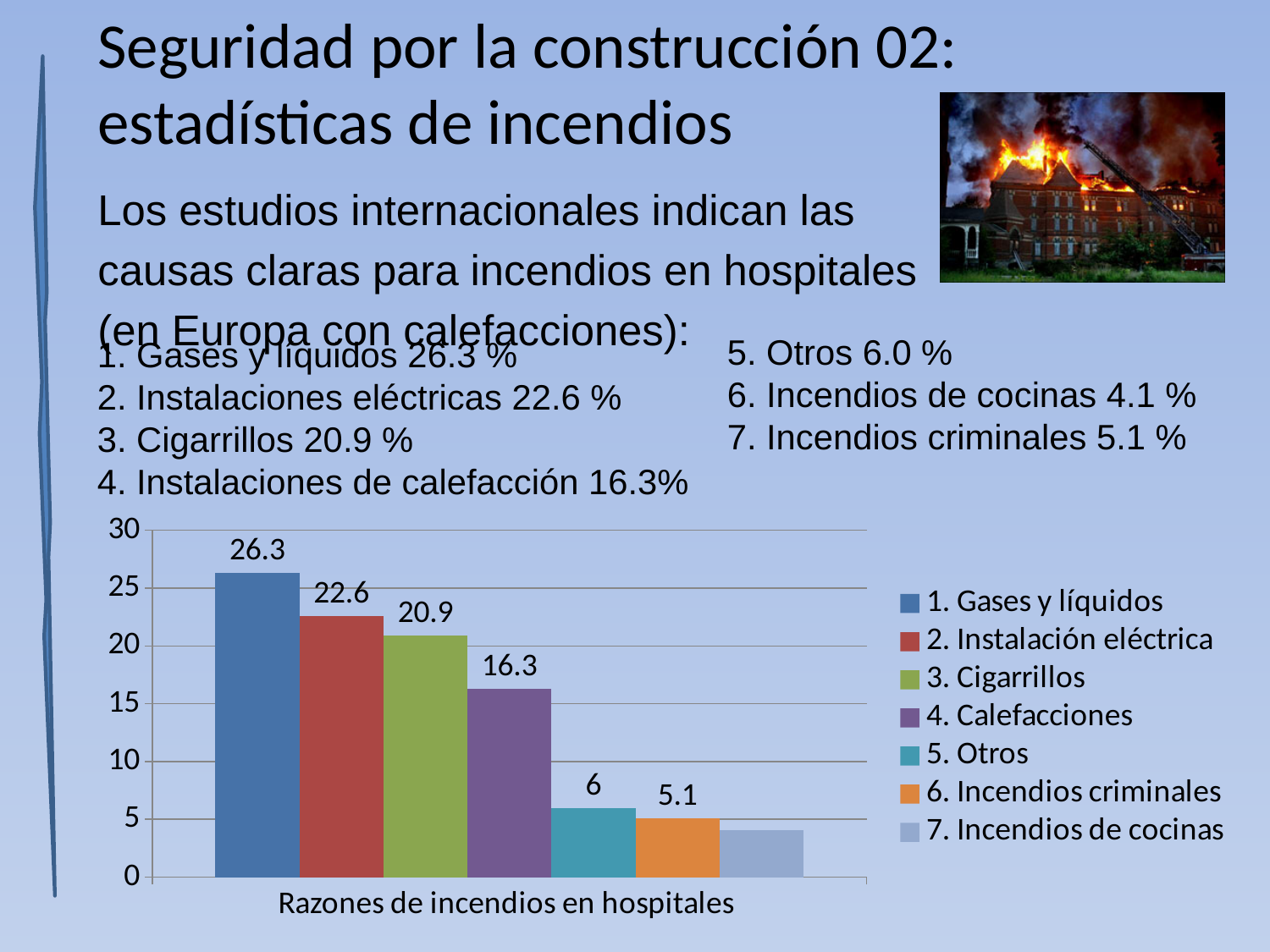
What is the value for 1. Gases y líquidos in the chart? 26.3 Which series has the lowest value in the chart? 7. Incendios de cocinas What is the difference between the values for 1. Gases y líquidos and 2. Instalación eléctrica? 3.7 What kind of chart is shown on the slide? bar chart Is the value for 7. Incendios de cocinas greater or less than 5? less What is the value for 5. Otros in the chart? 6 What is the label shown below the x axis of the chart? Razones de incendios en hospitales Which series has the highest value in the chart? 1. Gases y líquidos What is the value for 4. Calefacciones in the chart? 16.3 What is the value for 3. Cigarrillos in the chart? 20.9 How many series does the legend list? 7 Which is larger, the value for 2. Instalación eléctrica or the value for 3. Cigarrillos? 2. Instalación eléctrica